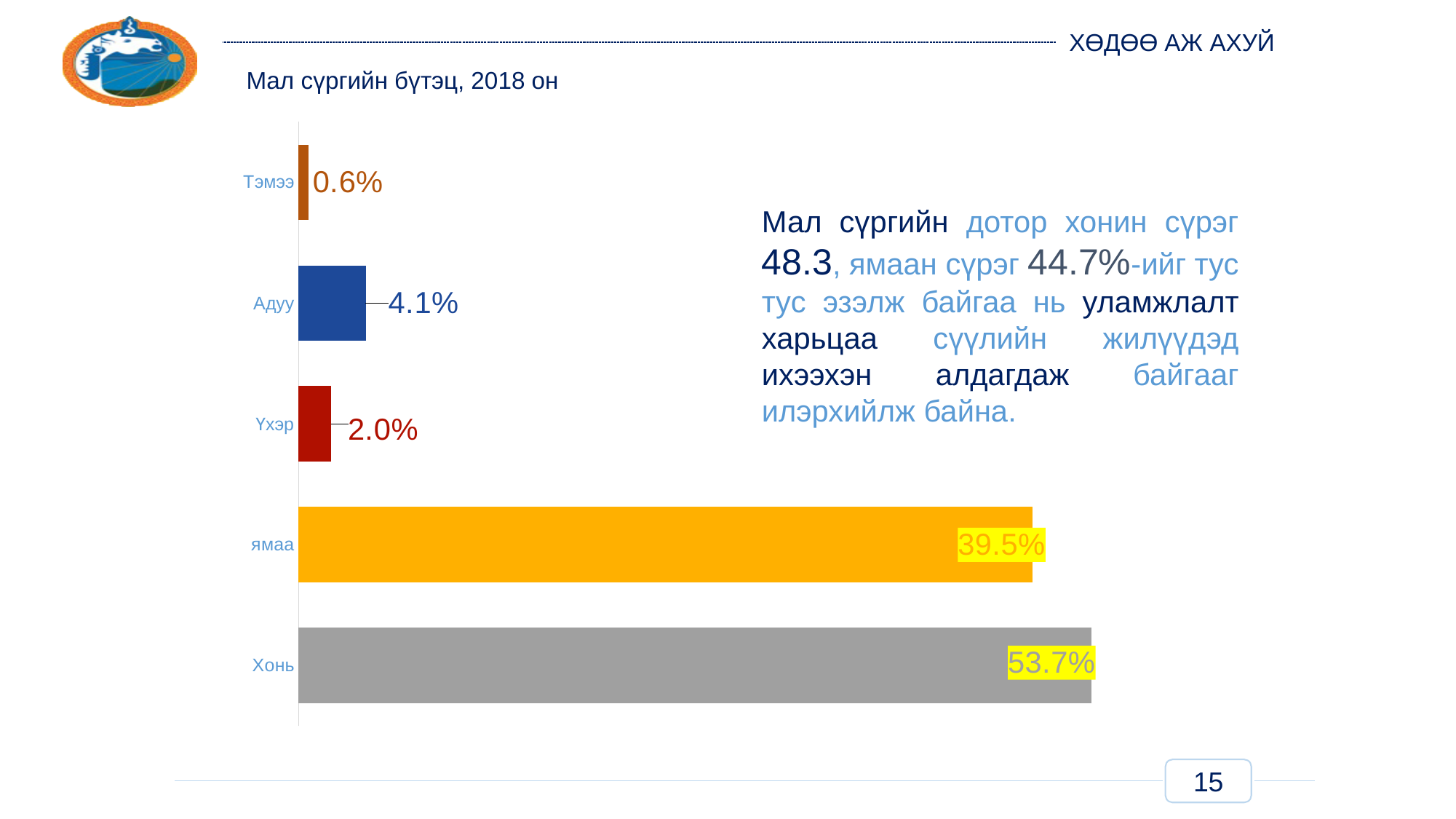
Which category has the lowest value? Тэмээ Which category has the highest value? Хонь What is the value for Адуу? 4.1% How many categories are shown in the chart? 5 What is the value for ямаа? 39.5% What is the value for Үхэр? 2.0% Which is larger, the value for Адуу or the value for Үхэр? Адуу What kind of chart is shown on the slide? Bar chart What is the difference between the values for Адуу and Үхэр? 2.1% What is the value for Тэмээ? 0.6% What is the difference between the values for Хонь and ямаа? 14.2% What is the value for Хонь? 53.7%